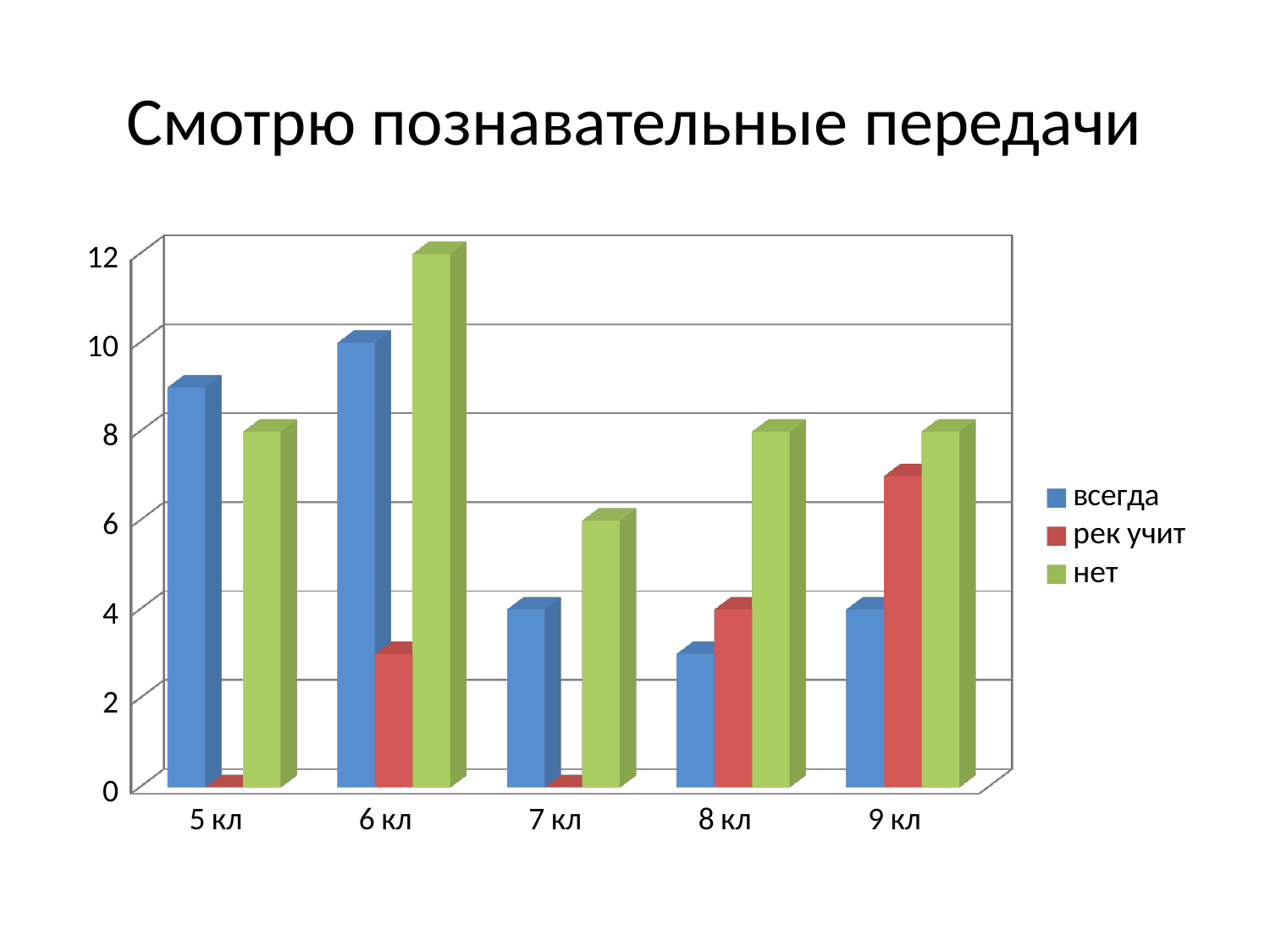
Which category has the lowest bar for the series 'нет'? 7 кл Which category has the highest bar for the series 'всегда'? 6 кл Is the value for 'рек учит' in 9 кл greater or less than 6? greater What kind of chart is shown on the slide? bar chart What is the title of the chart? Смотрю познавательные передачи In 9 кл, which is larger: 'всегда' or 'рек учит'? рек учит Is the value for 'всегда' in 5 кл greater or less than 8? greater Which category has the highest bar for the series 'рек учит'? 9 кл How many class categories are shown on the x axis? 5 Is the value for 'всегда' in 8 кл greater or less than 4? less Which category has the highest bar for the series 'нет'? 6 кл How many series does the legend list? 3